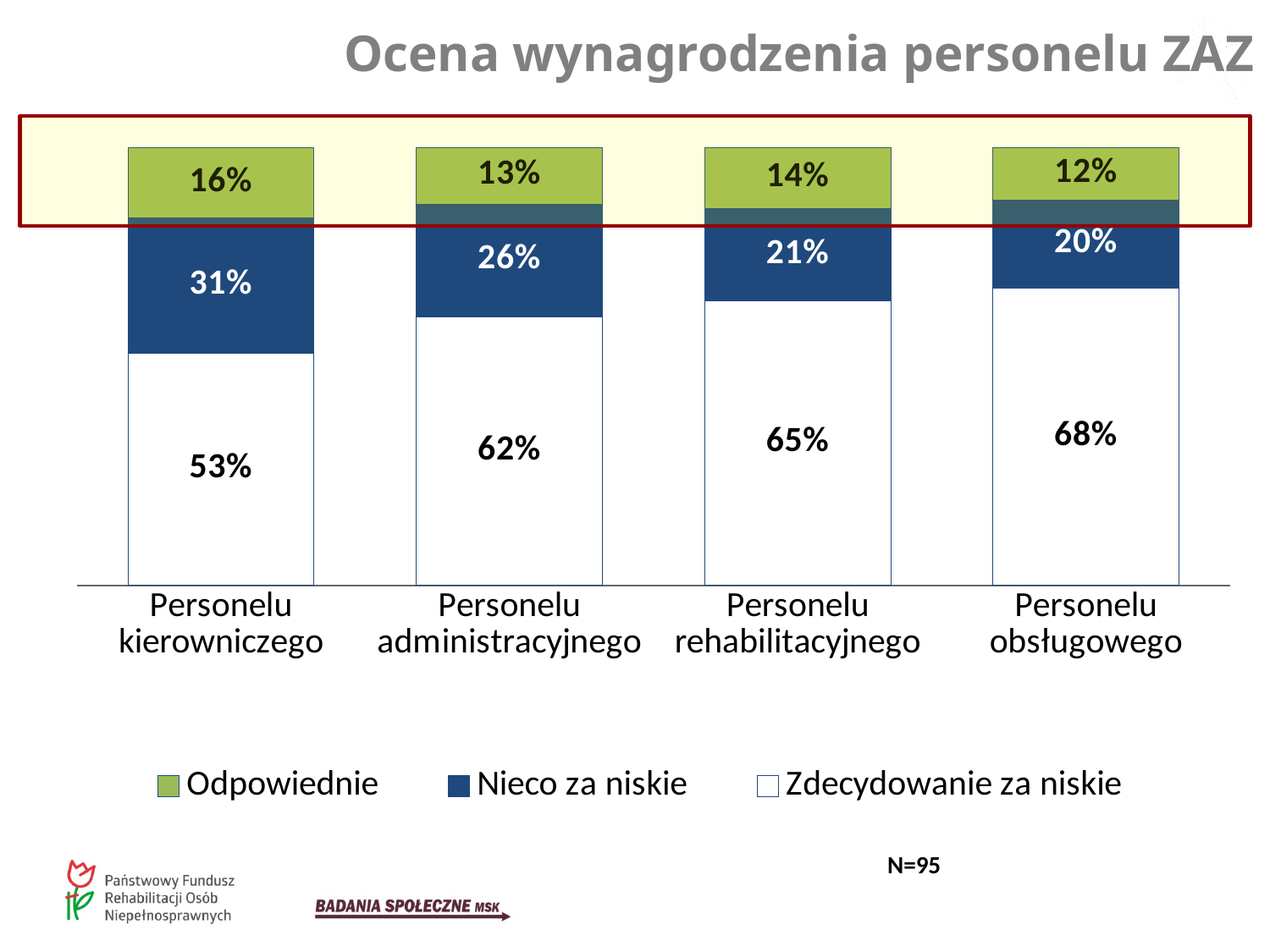
What is the title of the chart? Ocena wynagrodzenia personelu ZAZ What is the 'Zdecydowanie za niskie' value for Personelu kierowniczego? 53% What is the difference between the 'Nieco za niskie' values for Personelu kierowniczego and Personelu obsługowego? 11% What is the 'Nieco za niskie' value for Personelu administracyjnego? 26% Which is larger: the 'Zdecydowanie za niskie' value for Personelu administracyjnego or for Personelu rehabilitacyjnego? Personelu rehabilitacyjnego Do the 'Zdecydowanie za niskie' values rise or fall from left to right along the x axis? Rise How many categories are shown on the x axis? 4 Which category has the lowest 'Odpowiednie' value? Personelu obsługowego What is the 'Odpowiednie' value for Personelu rehabilitacyjnego? 14% What kind of chart is shown on the slide? Stacked bar chart How many series does the legend list? 3 Which category has the highest 'Zdecydowanie za niskie' value? Personelu obsługowego